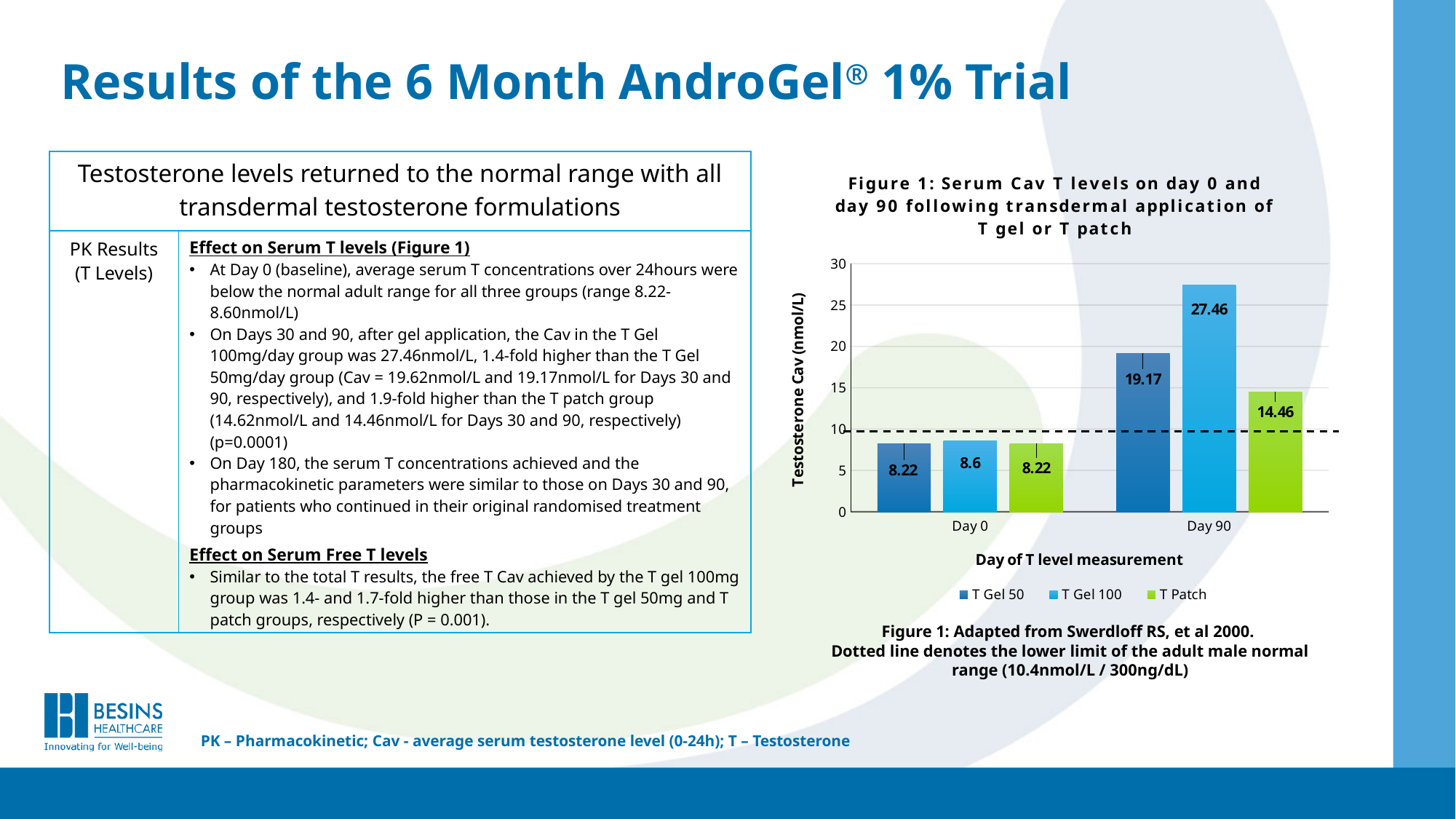
How many day categories are shown on the x axis? 2 What is the difference between the T Gel 100 and T Gel 50 values on Day 90? 8.29 What is the serum Cav T level for T Gel 100 on Day 90? 27.46 What is the y-axis label of the chart? Testosterone Cav (nmol/L) Which is larger on Day 90: the T Gel 50 value or the T Patch value? T Gel 50 What kind of chart is shown in Figure 1? bar chart Is the value for T Gel 100 on Day 0 greater or less than 10? less What is the serum Cav T level for T Gel 50 on Day 90? 19.17 Which series has the lowest value on Day 90? T Patch How many series does the legend list? 3 Which series has the highest value on Day 90? T Gel 100 What is the serum Cav T level for T Patch on Day 0? 8.22